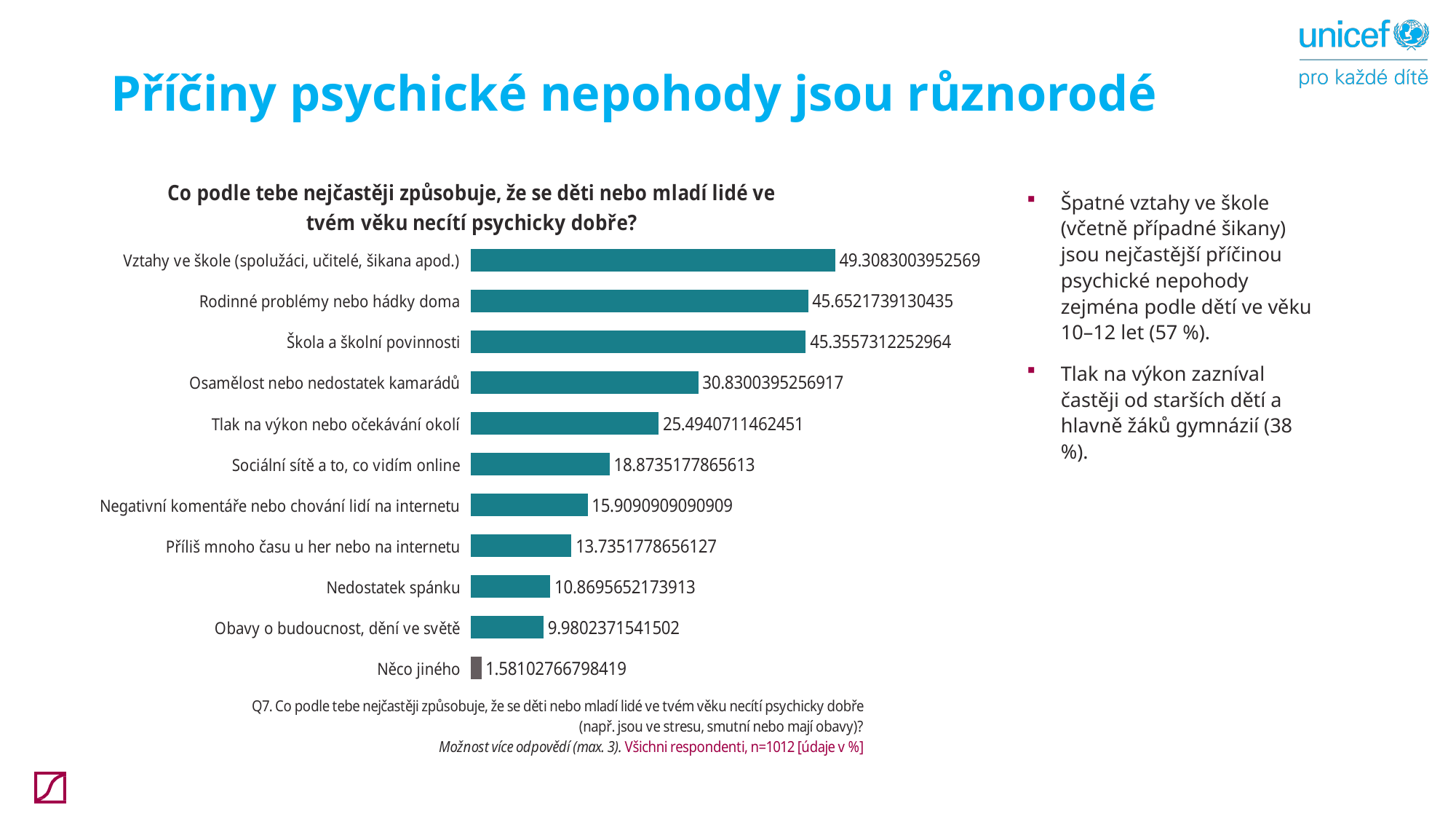
Which category has the highest value in the chart? Vztahy ve škole (spolužáci, učitelé, šikana apod.) Which bar in the chart is coloured differently from the teal bars? Něco jiného What is the title of the chart? Co podle tebe nejčastěji způsobuje, že se děti nebo mladí lidé ve tvém věku necítí psychicky dobře? Which is larger: the value for "Tlak na výkon nebo očekávání okolí" or the value for "Sociální sítě a to, co vidím online"? Tlak na výkon nebo očekávání okolí What value is shown for "Něco jiného"? 1.58102766798419 What value is shown for "Vztahy ve škole (spolužáci, učitelé, šikana apod.)"? 49.3083003952569 What type of chart is shown on the slide? Bar chart Which category has the lowest value in the chart? Něco jiného What value is shown for "Osamělost nebo nedostatek kamarádů"? 30.8300395256917 How many categories are shown in the chart? 11 What value is shown for "Nedostatek spánku"? 10.8695652173913 What is the difference between the values for "Vztahy ve škole (spolužáci, učitelé, šikana apod.)" and "Rodinné problémy nebo hádky doma"? 3.6561264822134